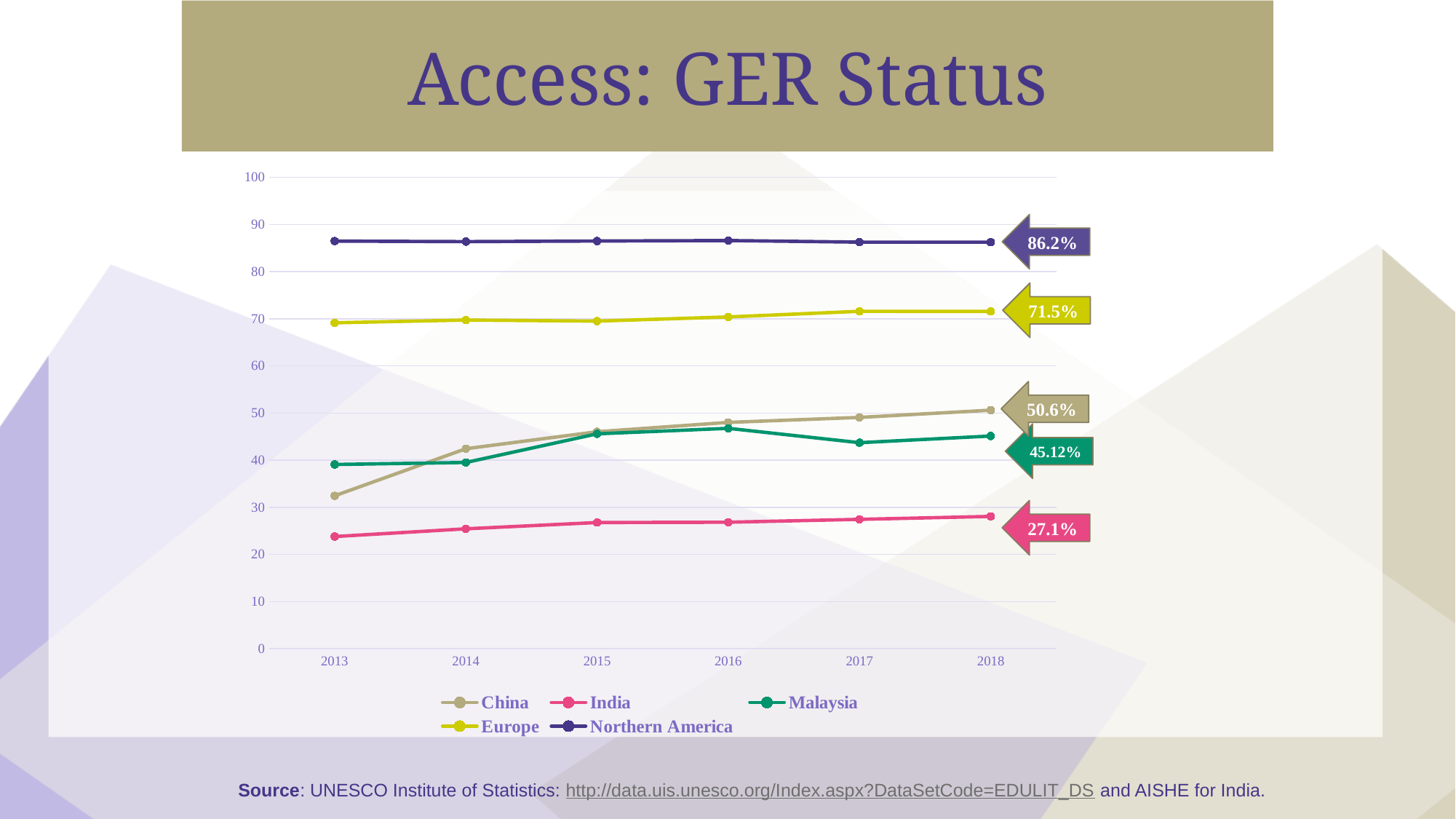
What is the 2018 value labelled for Europe? 71.5% What is the 2018 value labelled for China? 50.6% Is the value for China in 2013 greater or less than 40? less How many series does the legend list? 5 How many years are shown on the x axis? 6 What is the 2018 value labelled for India? 27.1% What kind of chart is shown on the slide? line chart What is the difference between the 2018 values for Northern America and India? 59.1% Which series has the highest value in 2018? Northern America Which series has the lowest value in 2018? India What is the 2018 value labelled for Malaysia? 45.12% What is the 2018 value labelled for Northern America? 86.2%